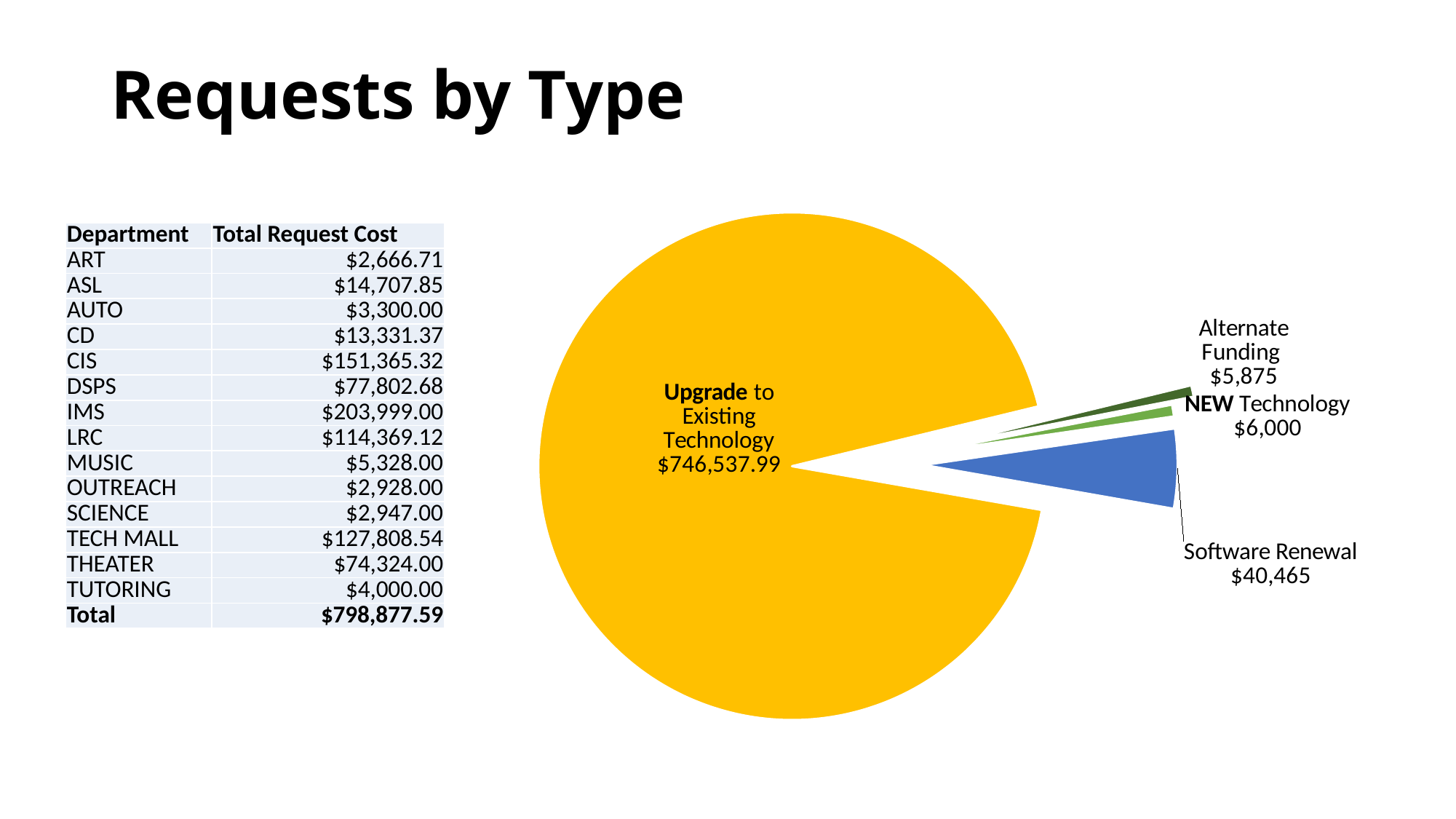
Which slice of the pie chart is the largest? Upgrade to Existing Technology How many slices does the pie chart have? 4 What kind of chart is shown on the slide? Pie chart Which slice of the pie chart is the smallest? Alternate Funding What is the difference between the Software Renewal and NEW Technology values in the pie chart? $34,465 In the pie chart, which is larger: NEW Technology or Alternate Funding? NEW Technology What is the value of the NEW Technology slice in the pie chart? $6,000 What colour is the Software Renewal slice in the pie chart? Blue What is the difference between the NEW Technology and Alternate Funding values in the pie chart? $125 What is the value of the Software Renewal slice in the pie chart? $40,465 What is the value of the Alternate Funding slice in the pie chart? $5,875 What is the value of the Upgrade to Existing Technology slice in the pie chart? $746,537.99